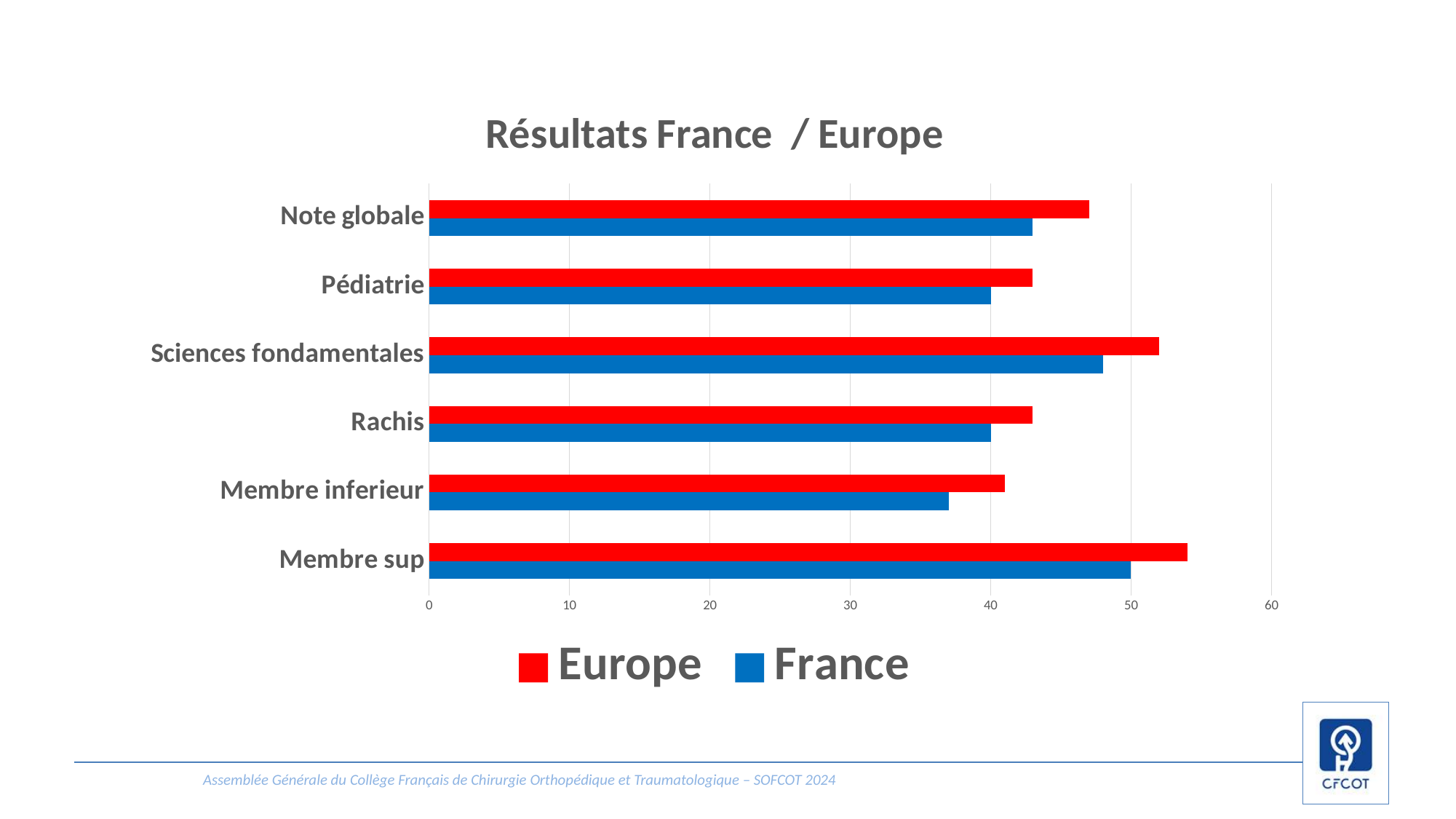
How many series does the legend list? 2 What is the France value for Rachis? 40 What is the title of the chart? Résultats France / Europe Which category has the lowest France value? Membre inferieur For Sciences fondamentales, which is larger, the Europe value or the France value? Europe Is the Europe value for Membre sup greater or less than 50? greater What is the France value for Membre sup? 50 Which category has the highest Europe value? Membre sup What kind of chart is shown on the slide? bar chart How many categories are shown on the chart? 6 Is the France value for Membre inferieur greater or less than 40? less Is the Europe value for Note globale greater or less than 50? less